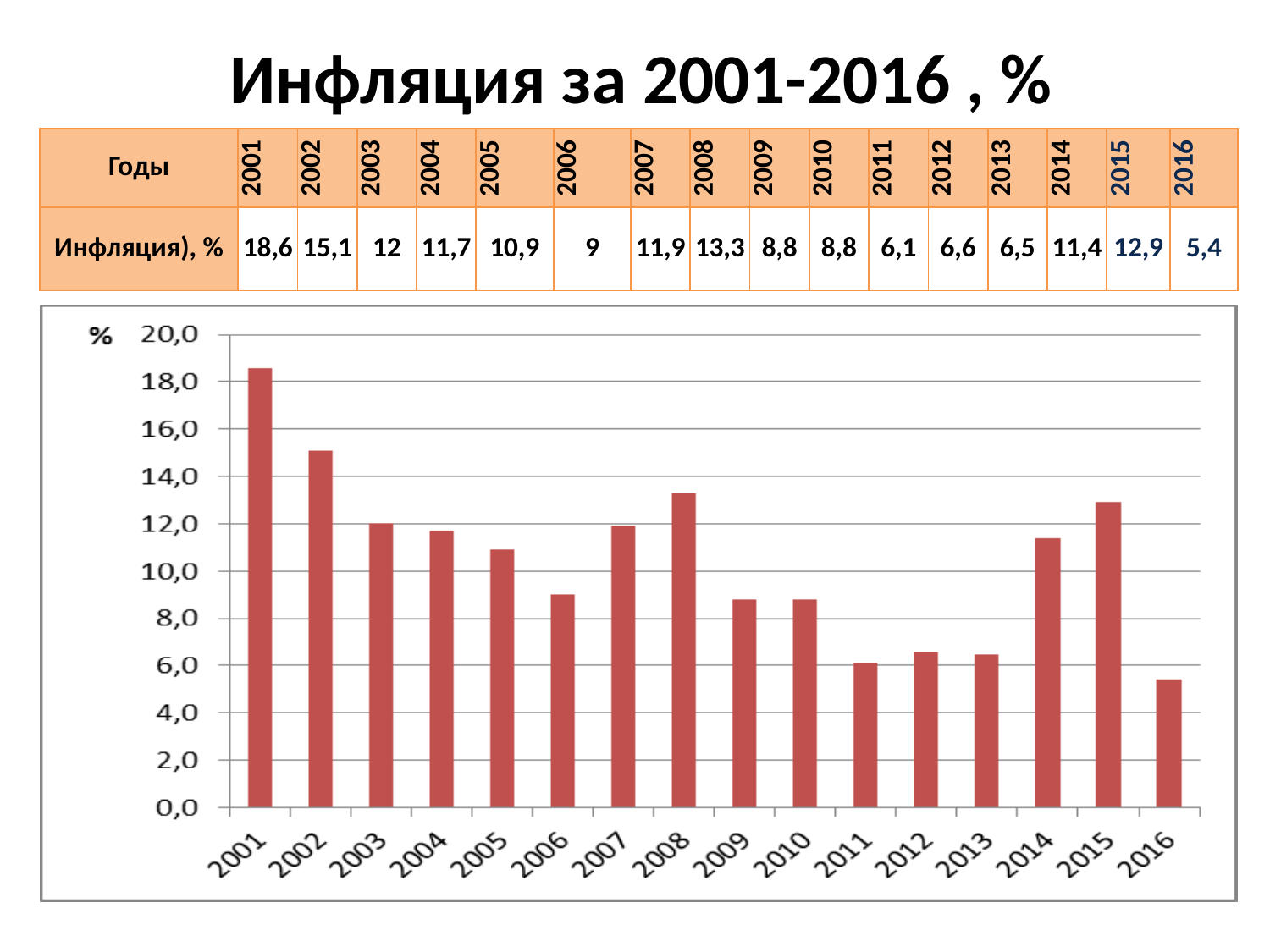
Which year has the highest inflation? 2001 Do the inflation values rise or fall from 2001 to 2006? fall What is the difference between the inflation values for 2001 and 2016? 13,2 Which year has the larger inflation value, 2014 or 2015? 2015 What kind of chart is shown on the slide? bar chart How many years are shown on the x axis of the chart? 16 What is the inflation value for 2001? 18,6 Which year has the lowest inflation? 2016 What is the inflation value for 2016? 5,4 What is the difference between the inflation values for 2008 and 2007? 1,4 What is the inflation value for 2008? 13,3 Is the value for 2008 greater or less than 12,0? greater